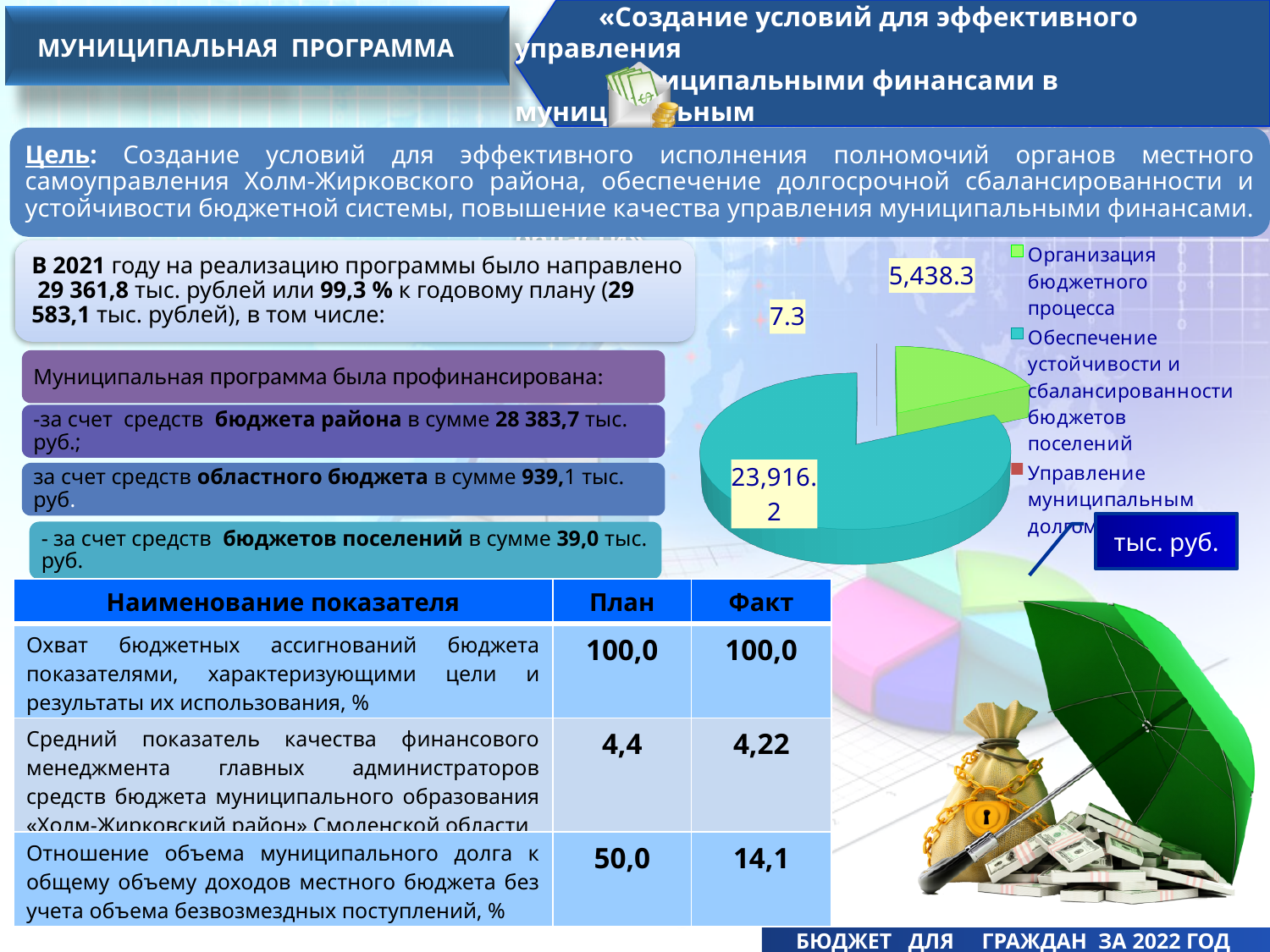
What unit is indicated for the values in the pie chart? тыс. руб. What is the value of the 'Организация бюджетного процесса' slice in the pie chart? 5,438.3 What is the difference between the 'Обеспечение устойчивости и сбалансированности бюджетов поселений' slice and the 'Организация бюджетного процесса' slice in the pie chart? 18,477.9 How many entries does the legend of the pie chart list? 3 In the pie chart, which is larger: 'Организация бюджетного процесса' or 'Управление муниципальным долгом'? Организация бюджетного процесса Which slice of the pie chart has the largest value? Обеспечение устойчивости и сбалансированности бюджетов поселений What is the value of the 'Обеспечение устойчивости и сбалансированности бюджетов поселений' slice in the pie chart? 23,916.2 What is the value of the 'Управление муниципальным долгом' slice in the pie chart? 7.3 How many slices does the pie chart have? 3 What kind of chart is shown on the slide? pie chart What colour is the 'Организация бюджетного процесса' slice in the pie chart? green Which slice of the pie chart has the smallest value? Управление муниципальным долгом